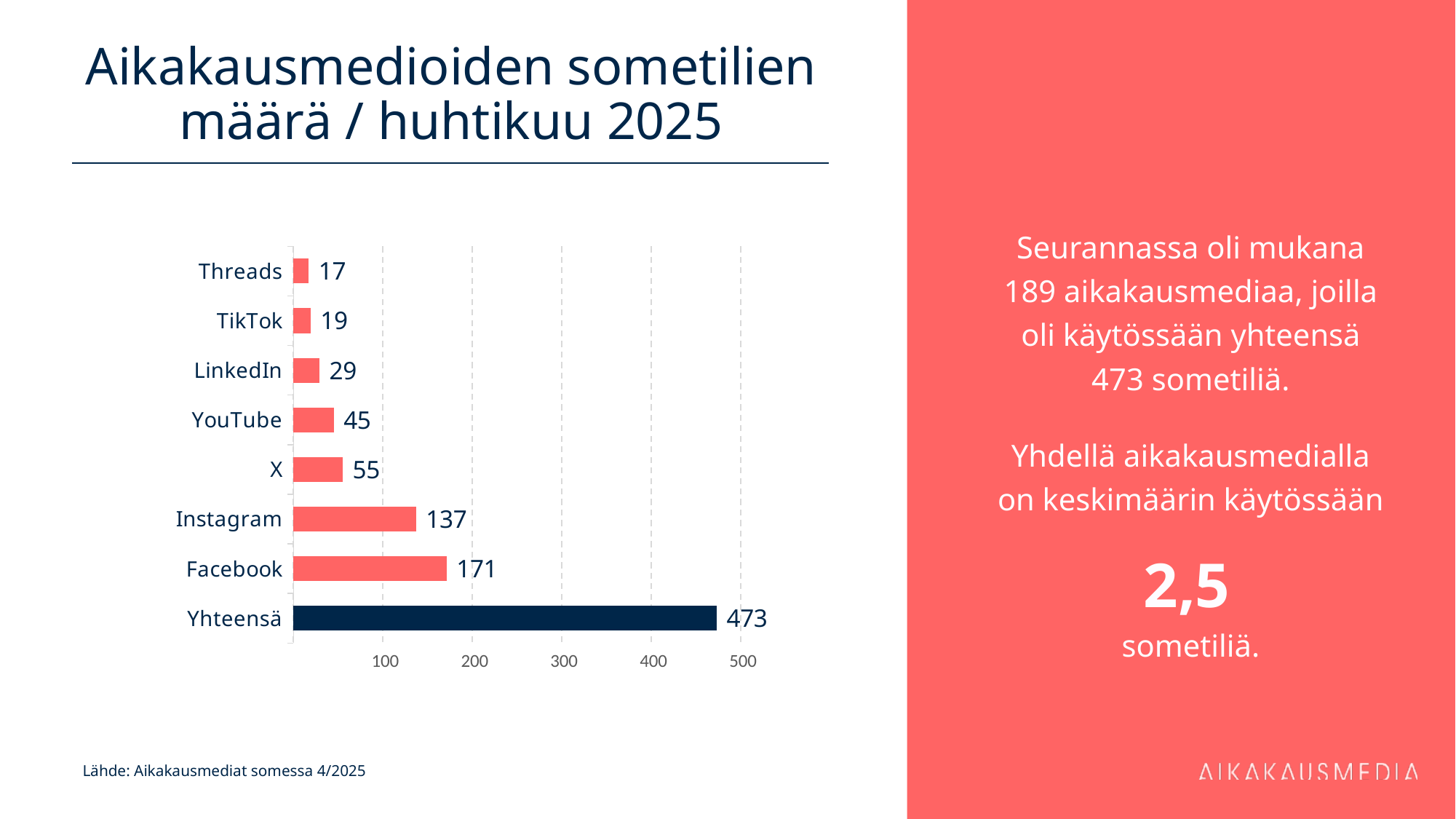
Which platform has the lowest value? Threads What kind of chart is shown on the slide? bar chart What is the value for LinkedIn? 29 What is the value for Instagram? 137 What is the value for Facebook? 171 How many bars are shown in the chart, including the Yhteensä total bar? 8 Is the value for Instagram greater or less than 100? greater Which has a larger value, X or YouTube? X What is the title of the chart on the slide? Aikakausmedioiden sometilien määrä / huhtikuu 2025 What is the value shown for Yhteensä? 473 What is the difference between the values for Facebook and Instagram? 34 Excluding the Yhteensä total bar, which platform has the highest value? Facebook